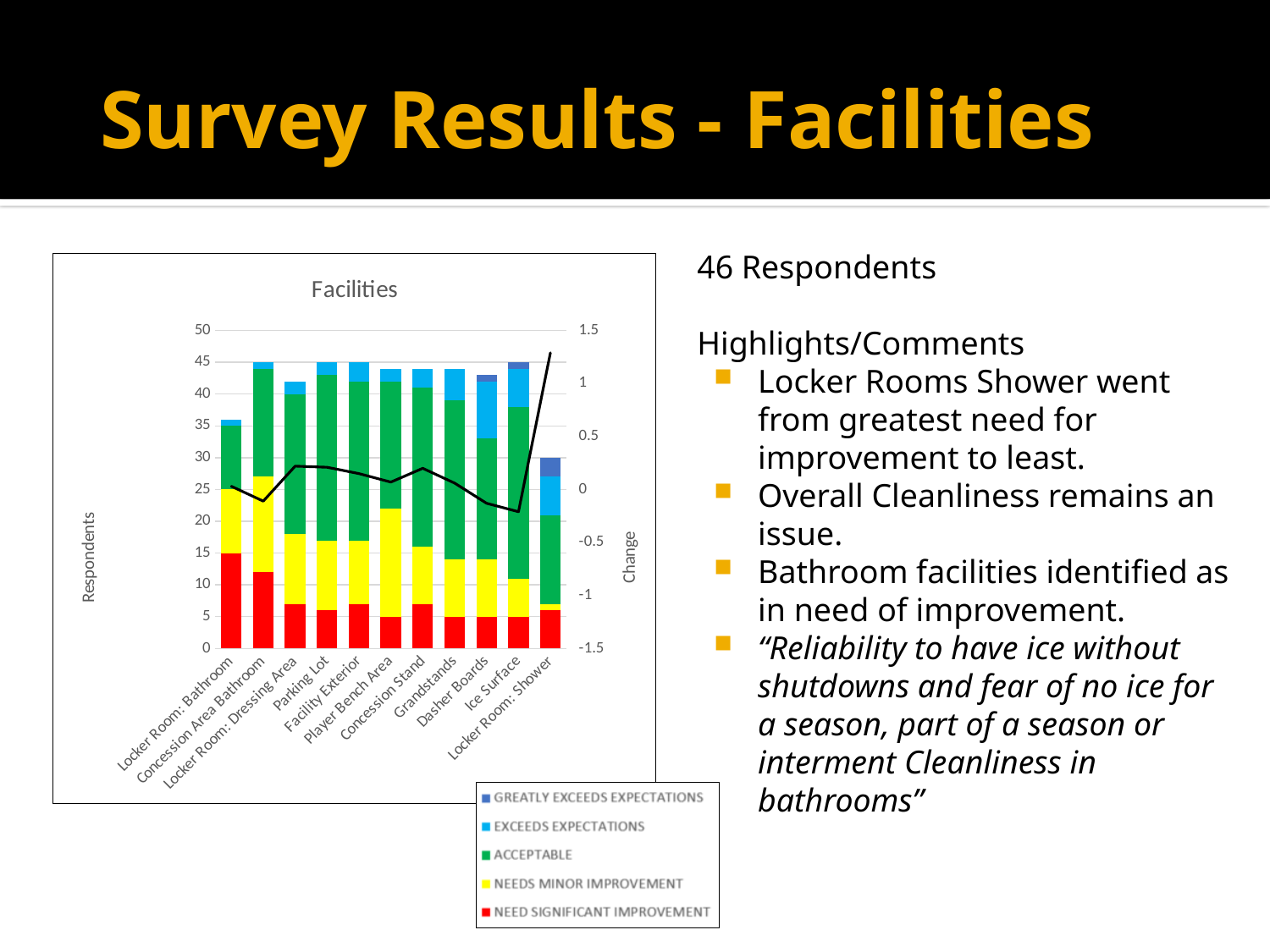
What is the title of the chart? Facilities Is the total bar height for Locker Room: Bathroom greater or less than 40? less Is the Need Significant Improvement value for Locker Room: Bathroom greater or less than 10? greater How many series does the chart legend list? 5 Which facility has the largest Need Significant Improvement (red) segment? Locker Room: Bathroom What is the label of the left vertical axis of the chart? Respondents How many facility categories are shown on the x axis of the chart? 11 What kind of chart is shown on the slide? Combination bar and line chart (stacked bars with a line) Is the total bar height for Locker Room: Shower greater or less than 35? less Which has a larger Need Significant Improvement segment, Locker Room: Bathroom or Parking Lot? Locker Room: Bathroom Which facility has the shortest total stacked bar? Locker Room: Shower